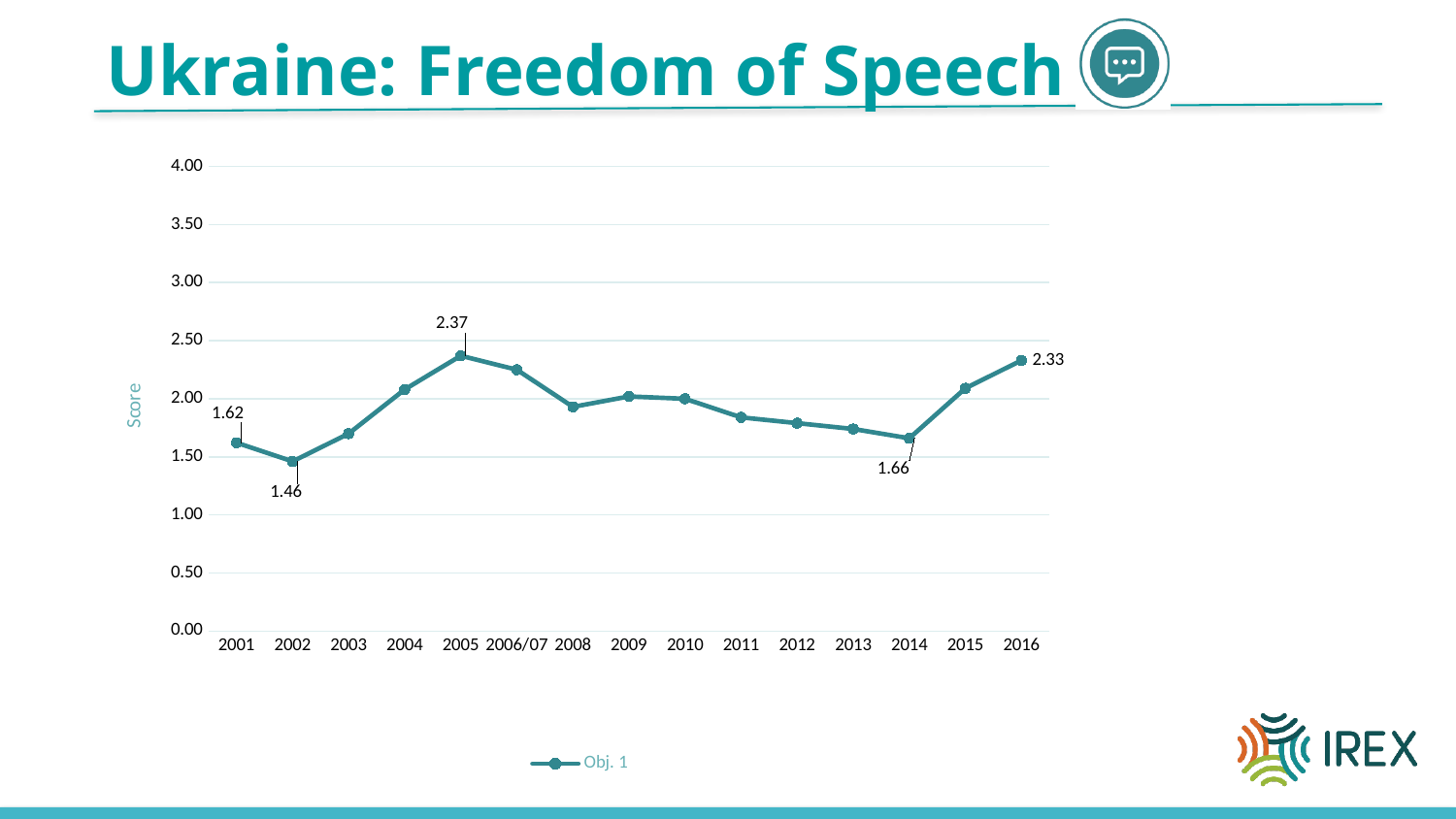
What is the score for 2014? 1.66 What is the score for 2002? 1.46 What is the difference between the score in 2005 and the score in 2002? 0.91 What is the score for 2005? 2.37 Which year has the highest score? 2005 What type of chart is shown on the slide? line chart Which year has the lowest score? 2002 Is the score for 2003 greater or less than 2.00? less What is the label of the series shown in the legend? Obj. 1 What is the difference between the score in 2016 and the score in 2014? 0.67 What is the score for 2016? 2.33 How many data points are plotted on the line? 15